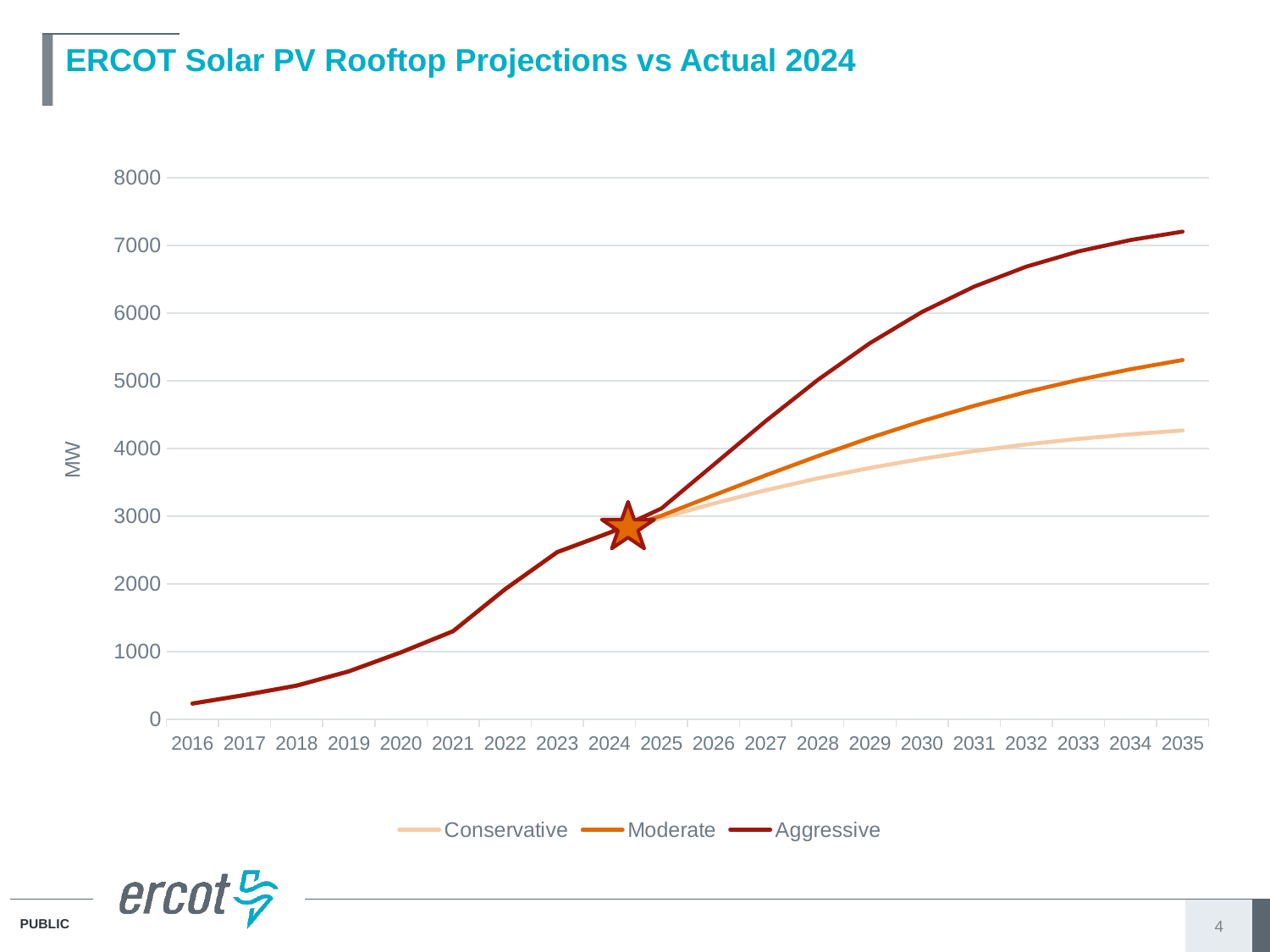
Do the values rise or fall from 2016 to 2035? rise Which series has the lowest value in 2035? Conservative Is the value for the Moderate series in 2035 greater or less than 5000? greater Is the value for the Aggressive series in 2035 greater or less than 7000? greater What kind of chart is shown on the slide? line chart How many years are shown on the x axis? 20 What is the label on the y axis? MW Which series has the highest value in 2035? Aggressive Is the value in 2016 greater or less than 1000? less How many series does the legend list? 3 Which is larger in 2035, the Moderate series or the Conservative series? Moderate